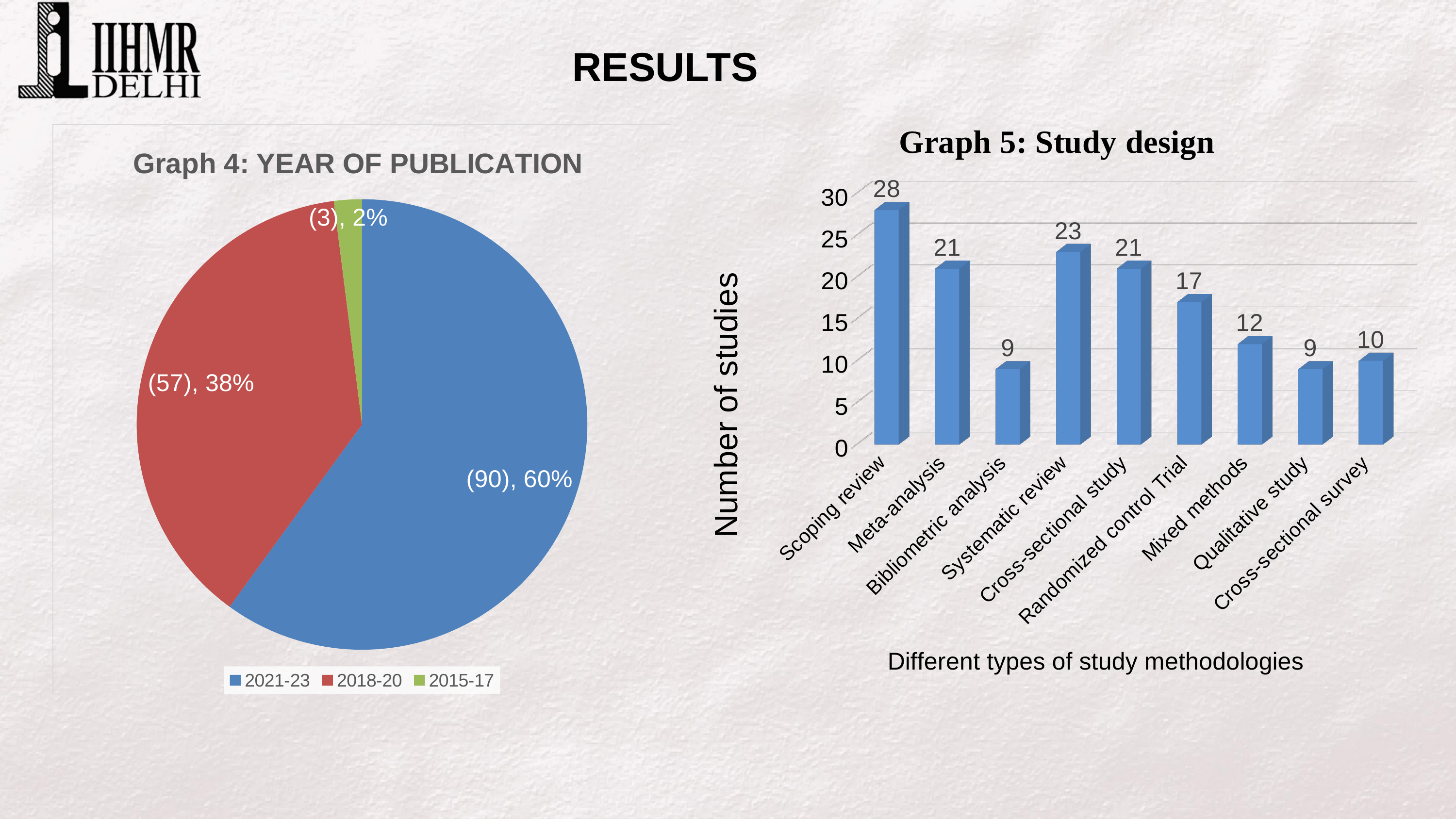
In Graph 5: Study design, what is the difference between the number of Systematic review studies and Randomized control Trial studies? 6 In Graph 4: YEAR OF PUBLICATION, what share of the pie does 2021-23 represent? 60% In Graph 4: YEAR OF PUBLICATION, how many periods does the legend list? 3 In Graph 5: Study design, how many study design categories are shown on the x axis? 9 In Graph 5: Study design, how many studies are Scoping reviews? 28 In Graph 5: Study design, what is the label of the vertical axis? Number of studies In Graph 4: YEAR OF PUBLICATION, which period has the smallest slice? 2015-17 What kind of chart is Graph 4: YEAR OF PUBLICATION? Pie chart What kind of chart is Graph 5: Study design? Bar chart In Graph 5: Study design, which study design has the highest number of studies? Scoping review In Graph 4: YEAR OF PUBLICATION, how many publications are in the 2018-20 slice? 57 In Graph 5: Study design, which has more studies, Mixed methods or Cross-sectional survey? Mixed methods